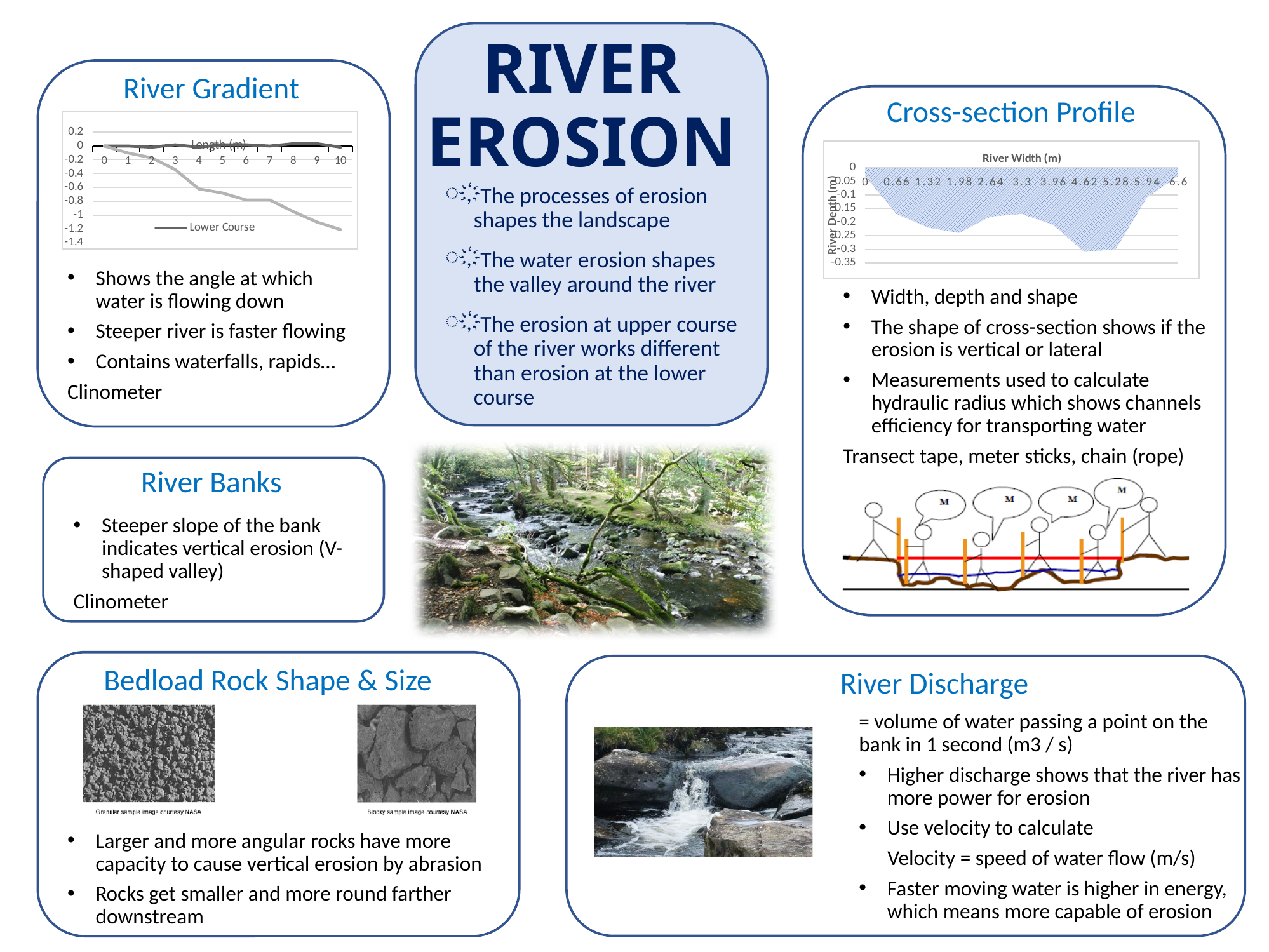
In the River Gradient chart, what series name does the legend show? Lower Course In the River Gradient chart, how many length values are labelled on the x axis? 11 What type of chart is shown in the River Gradient panel? line chart In the River Gradient chart, is the Lower Course value at length 2 greater or less than -0.4? greater In the River Gradient chart, is the Lower Course value at length 10 greater or less than -1? greater What type of chart is shown in the Cross-section Profile panel? area chart In the Cross-section Profile chart, what is the title of the horizontal axis? River Width (m) In the Cross-section Profile chart, how many river width values are labelled on the x axis? 11 In the Cross-section Profile chart, is the river depth at width 5.28 greater or less than -0.25? less